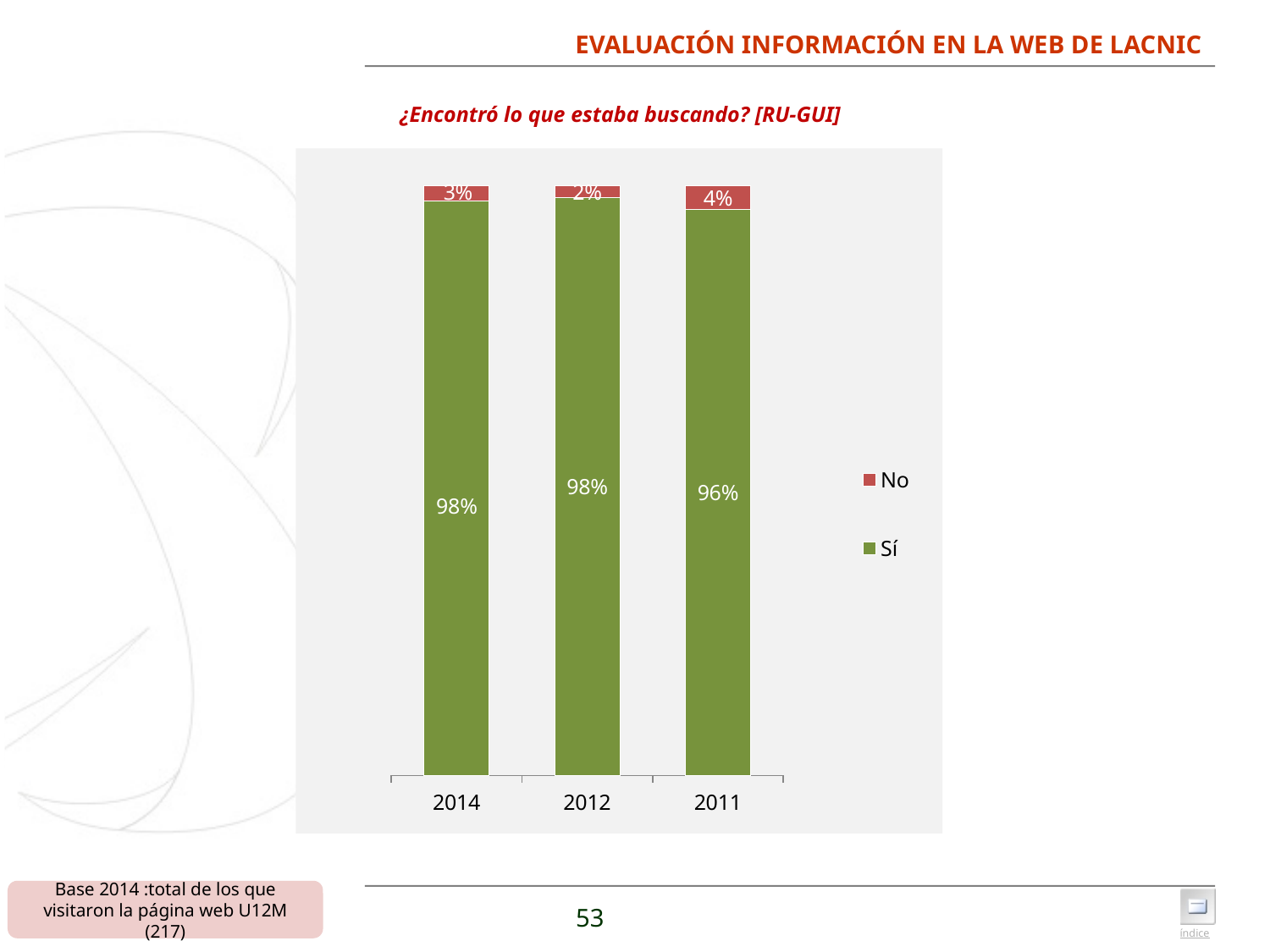
In which year is the "Sí" share lowest? 2011 What is the difference between the "Sí" value for 2014 and the "Sí" value for 2011? 2 percentage points Which is larger, the "No" value for 2014 or the "No" value for 2012? 2014 What is the "Sí" value for 2011? 96% What percentage answered "Sí" in 2014? 98% What are the two legend entries of the chart? No and Sí In which year is the "No" share highest? 2011 How many series does the legend list? 2 What kind of chart is shown? Stacked bar chart What is the "No" value for 2012? 2% What percentage answered "No" in 2011? 4% How many years are shown on the x axis? 3